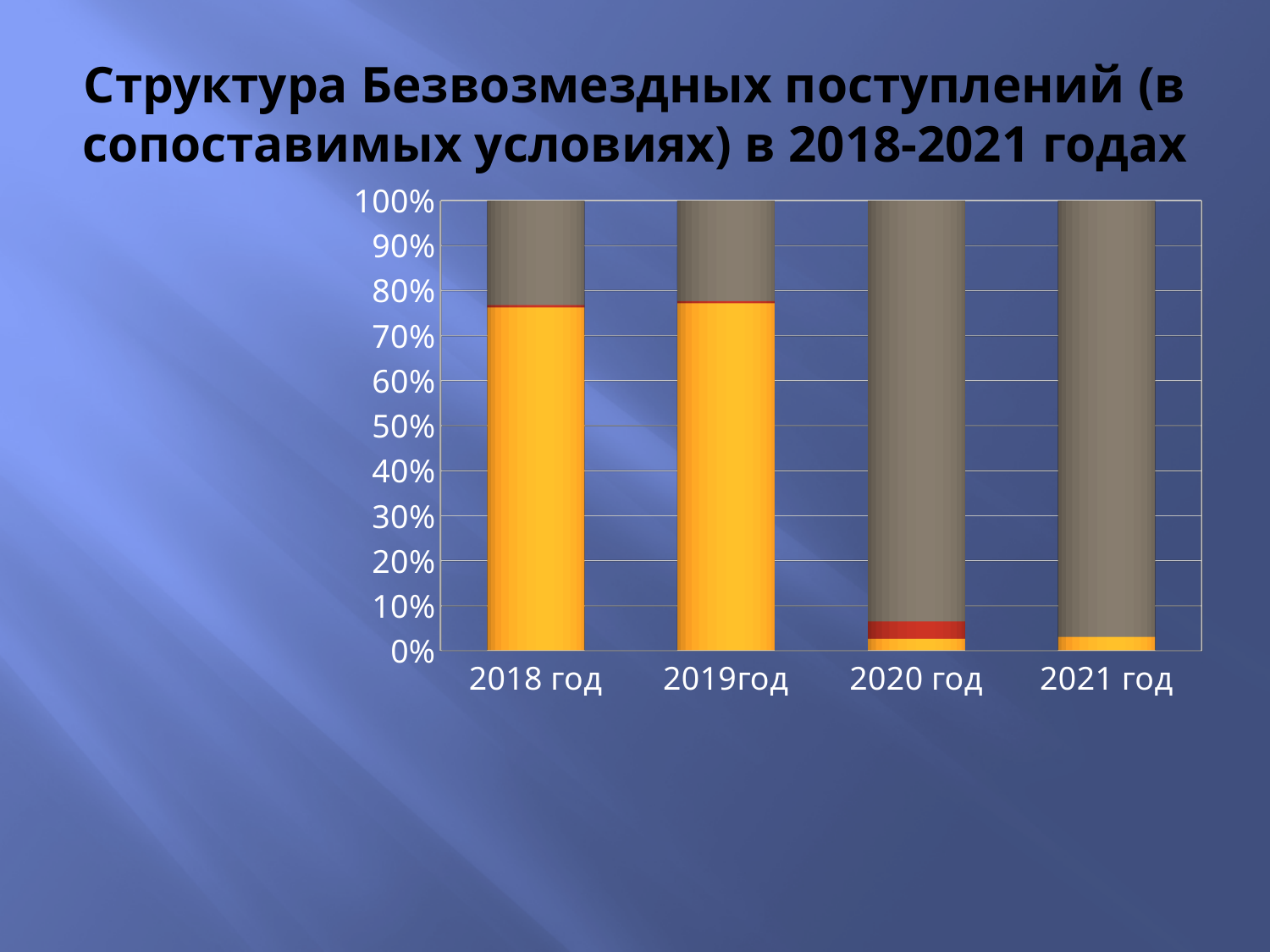
What is the maximum value shown on the y axis of the chart? 100% Which year has the larger grey segment, 2019год or 2020 год? 2020 год Does the yellow share rise or fall from 2019год to 2020 год? fall How many categories (years) are shown on the x axis of the chart? 4 Is the grey segment for 2018 год greater or less than 30%? less Is the yellow segment for 2018 год greater or less than 70%? greater What is the title of the chart on the slide? Структура Безвозмездных поступлений (в сопоставимых условиях) в 2018-2021 годах Is the yellow segment for 2019год greater or less than 80%? less Which year has the larger yellow segment, 2018 год or 2021 год? 2018 год What kind of chart is shown on the slide? stacked bar chart